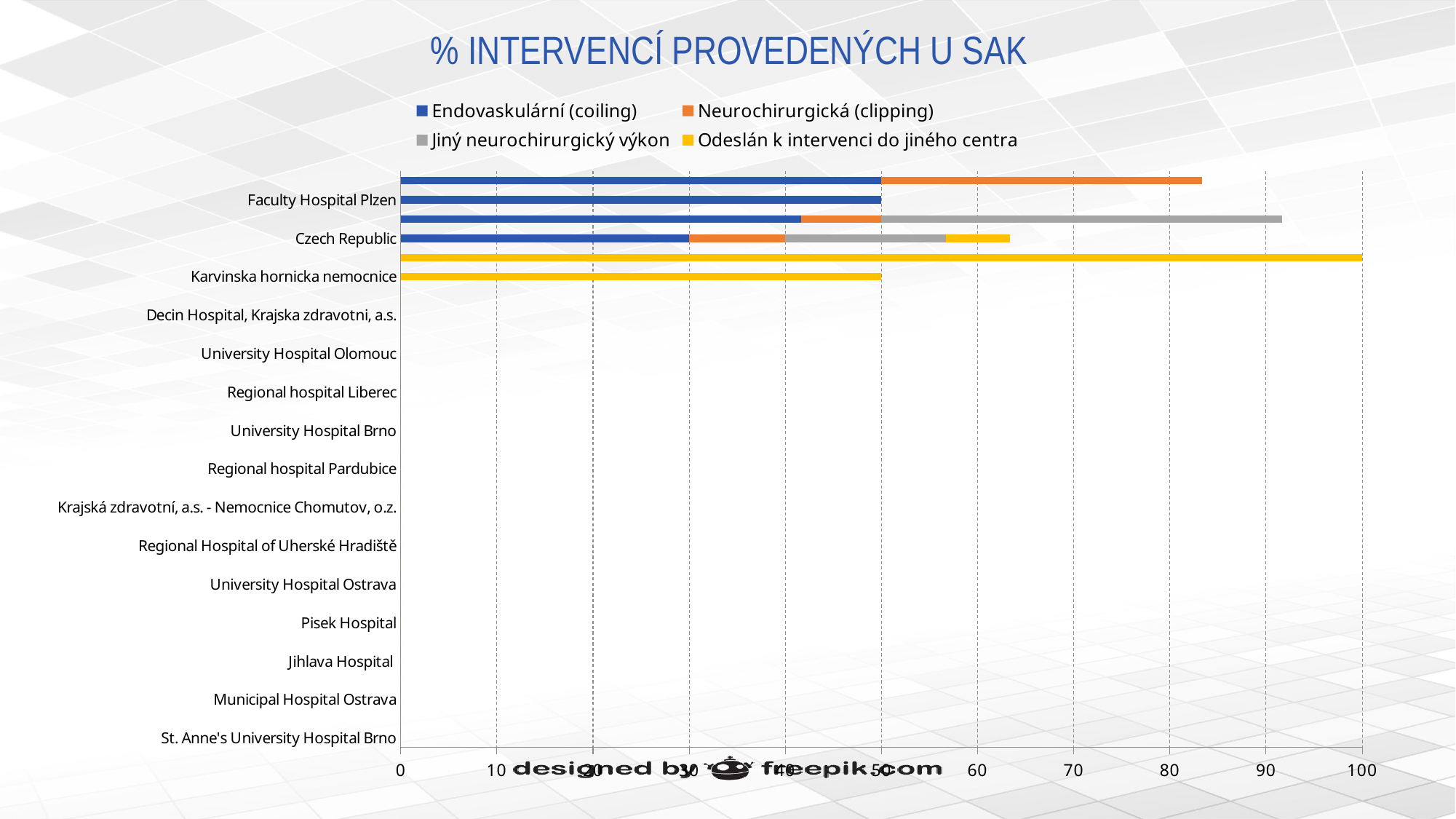
Is the Endovaskulární (coiling) value for Czech Republic greater or less than 40? less What is the maximum value shown on the horizontal axis? 100 What is the Endovaskulární (coiling) value for Czech Republic? 30 How many series does the legend list? 4 What kind of chart is shown on the slide? Stacked horizontal bar chart Which is larger, the Endovaskulární (coiling) value for Faculty Hospital Plzen or for Czech Republic? Faculty Hospital Plzen What is the title of the chart? % INTERVENCÍ PROVEDENÝCH U SAK What is the Odeslán k intervenci do jiného centra value for Karvinska hornicka nemocnice? 50 What is the difference between the Endovaskulární (coiling) values for Faculty Hospital Plzen and Czech Republic? 20 What is the Endovaskulární (coiling) value for Faculty Hospital Plzen? 50 Which series is shown in yellow in the legend? Odeslán k intervenci do jiného centra Is the total stacked value for Czech Republic greater or less than 60? greater